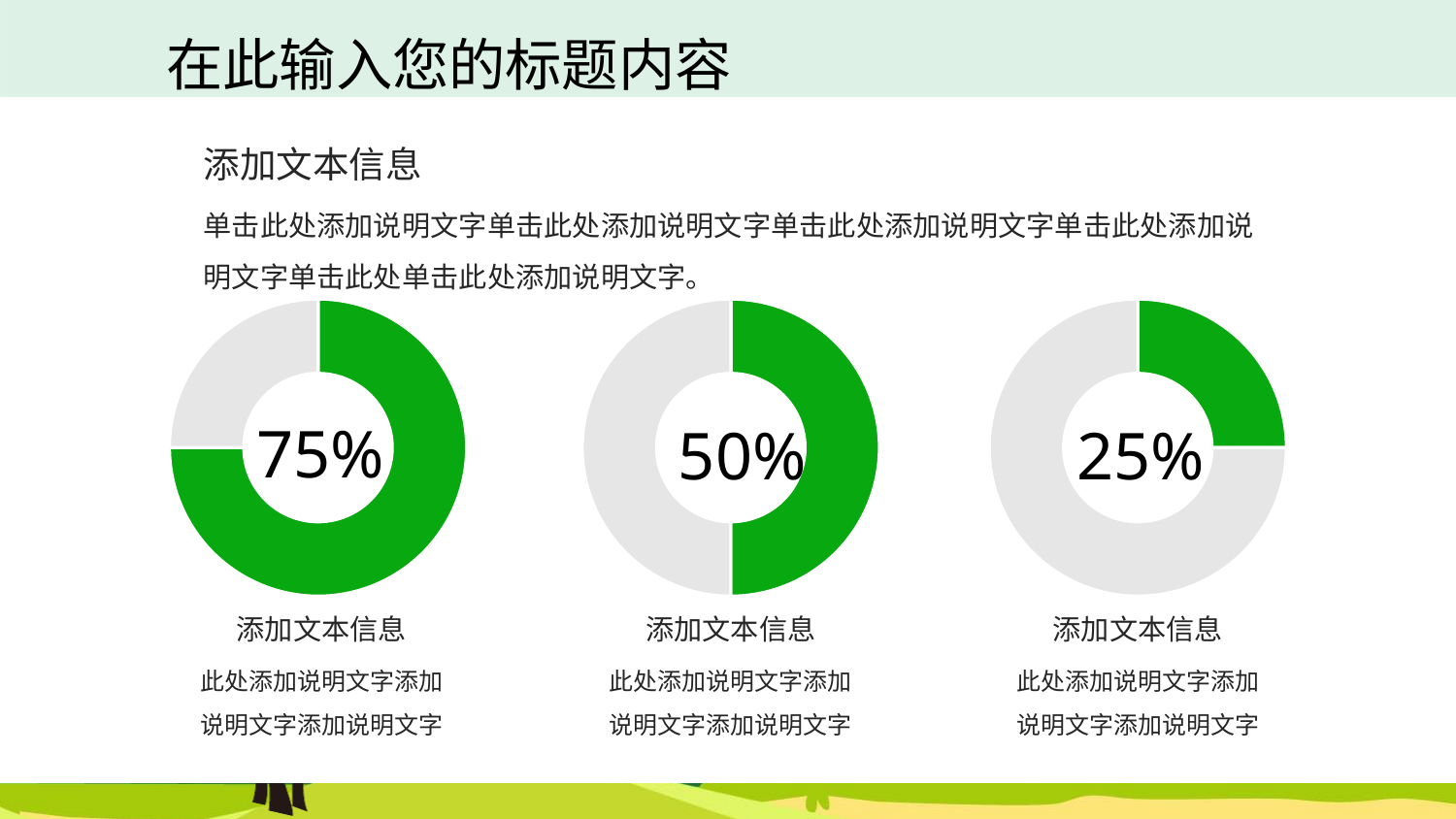
What is the difference between the percentage in the left donut chart and the percentage in the right donut chart? 50% What colour is the filled portion of each donut chart? Green How many donut charts are on the slide? 3 What is the difference between the percentage in the left donut chart and the percentage in the middle donut chart? 25% Which of the three donut charts shows the highest percentage? The left chart (75%) What percentage is shown in the centre of the left donut chart? 75% What kind of chart is used for the three percentages on the slide? Donut chart Do the percentages rise or fall going from the left chart to the right chart? Fall Which of the three donut charts shows the lowest percentage? The right chart (25%) What percentage is shown in the centre of the middle donut chart? 50% What percentage is shown in the centre of the right donut chart? 25% Which is larger, the percentage in the middle donut chart or the percentage in the right donut chart? The middle chart (50%)